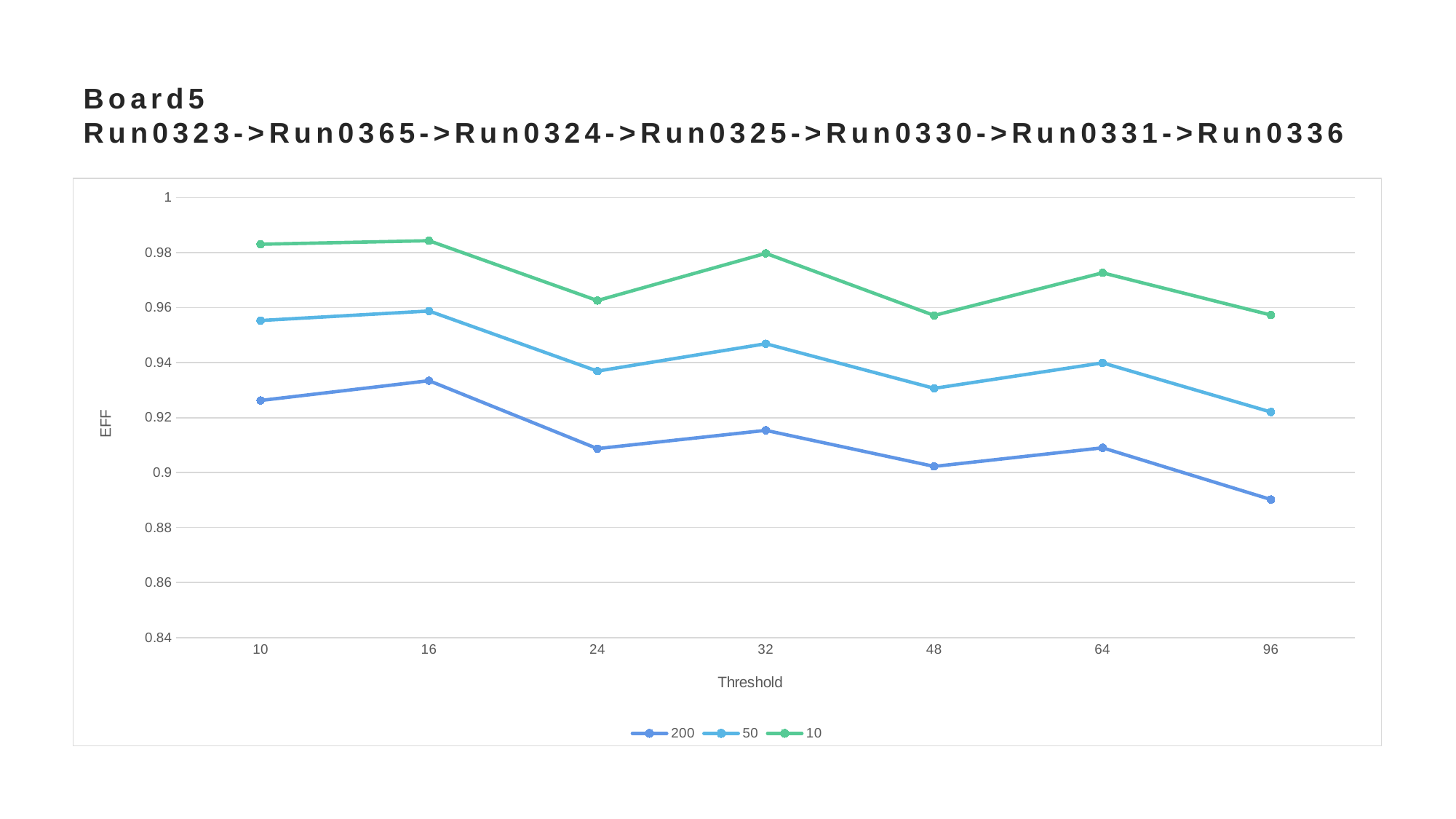
Is the value of the 200 series at threshold 96 greater or less than 0.9? less At which threshold does the 200 series reach its lowest EFF value? 96 What kind of chart is shown on the slide? line chart Which series has the highest EFF values across all thresholds? 10 Is the value of the 200 series at threshold 16 greater or less than 0.92? greater How many series does the legend list? 3 Overall, do the EFF values of the 200 series rise or fall from threshold 10 to threshold 96? fall At which threshold does the 200 series reach its highest EFF value? 16 Is the value of the 50 series at threshold 96 greater or less than 0.94? less How many threshold values are plotted along the x axis? 7 For the 200 series, is the value at threshold 10 or at threshold 24 larger? 10